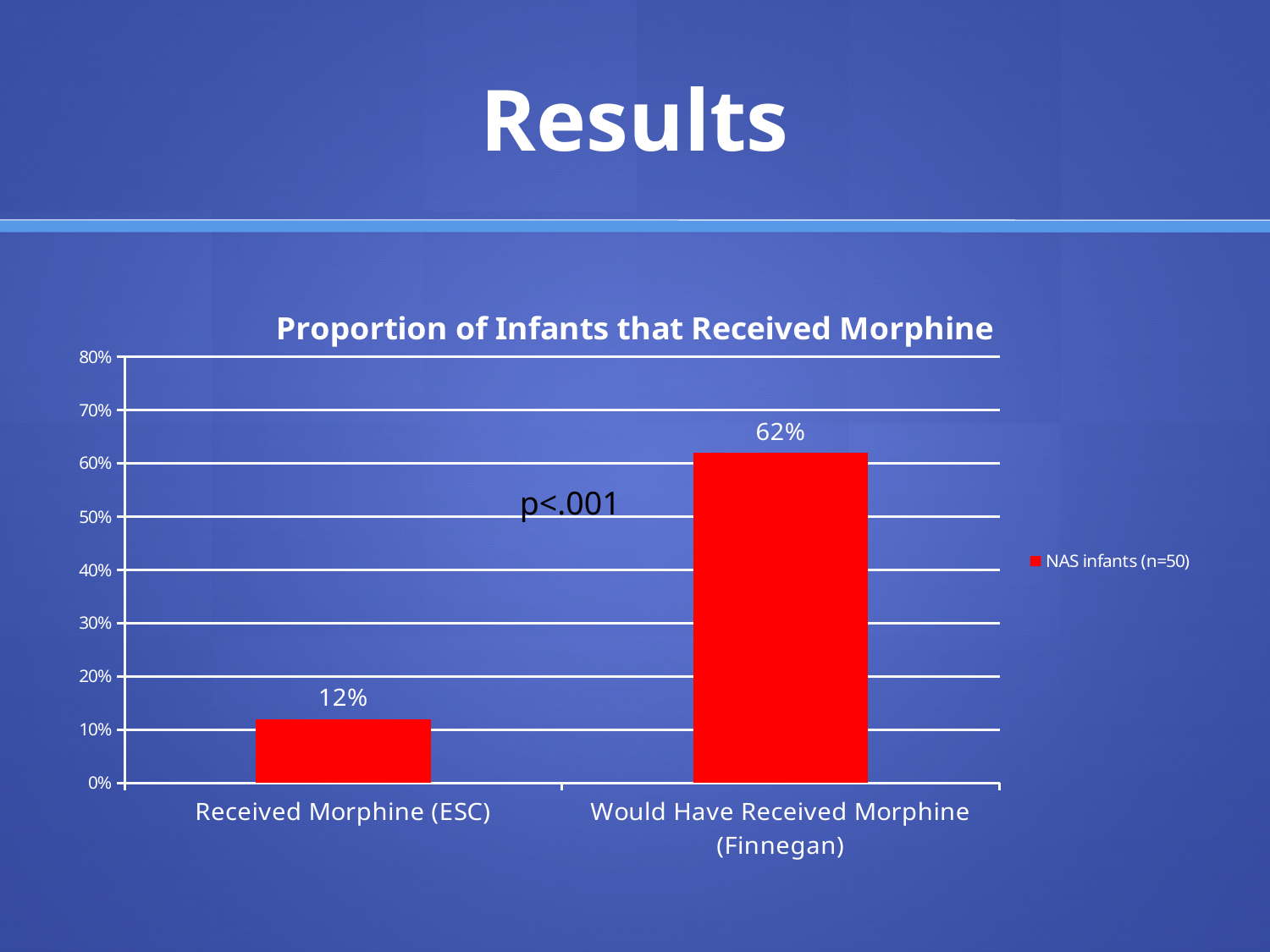
Is the value for Would Have Received Morphine (Finnegan) greater or less than 50%? greater What is the title of the chart? Proportion of Infants that Received Morphine What is the value for Would Have Received Morphine (Finnegan)? 62% What kind of chart is shown on the slide? bar chart How many series does the legend list? 1 How many categories are shown on the x axis? 2 Which category has the highest value? Would Have Received Morphine (Finnegan) Is the value for Received Morphine (ESC) greater or less than 20%? less Which is larger: the value for Received Morphine (ESC) or the value for Would Have Received Morphine (Finnegan)? Would Have Received Morphine (Finnegan) What is the value for Received Morphine (ESC)? 12% Which category has the lowest value? Received Morphine (ESC) What is the difference between the values for Would Have Received Morphine (Finnegan) and Received Morphine (ESC)? 50%